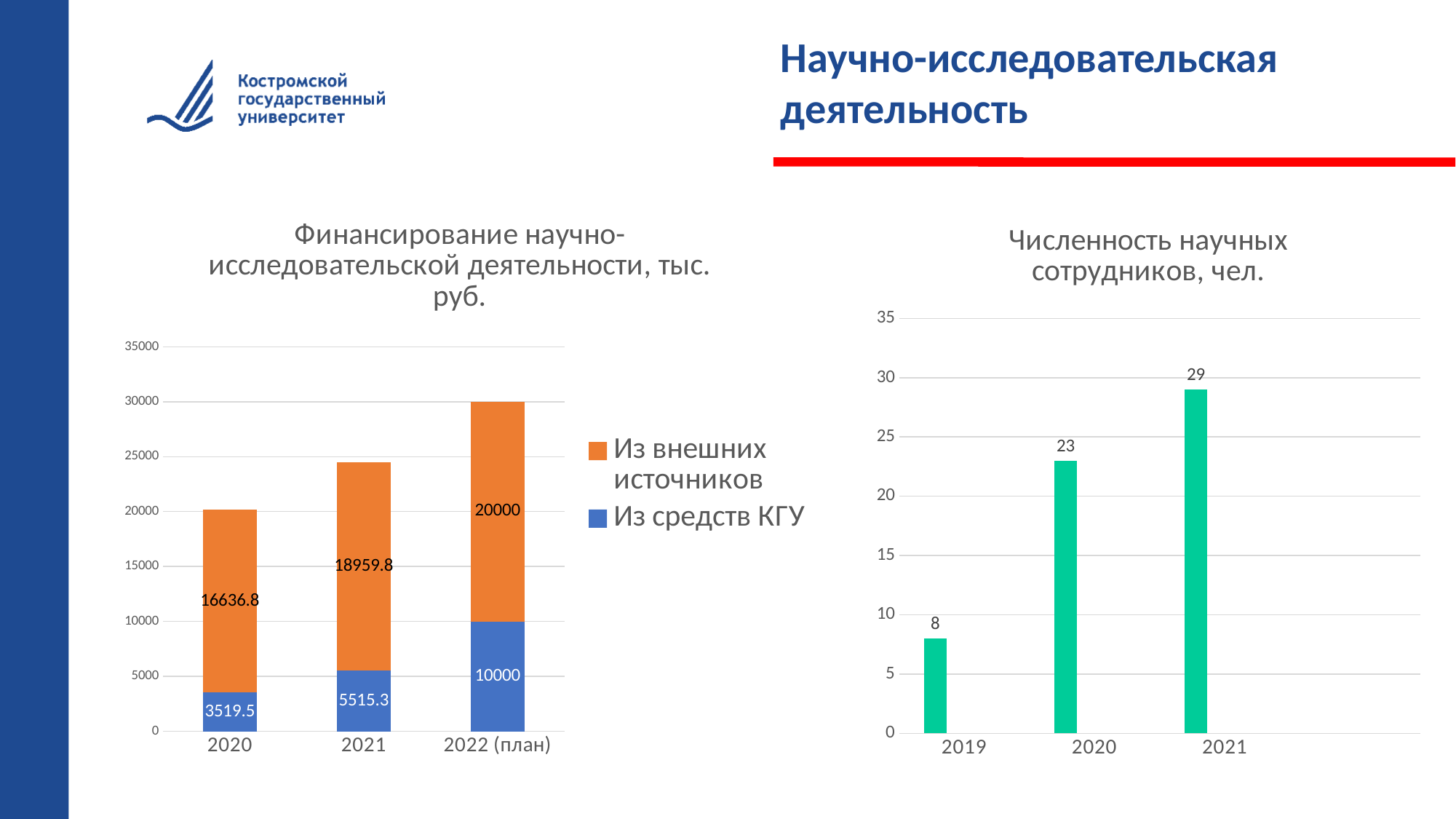
In the chart 'Финансирование научно-исследовательской деятельности, тыс. руб.', what is the value for 'Из средств КГУ' in 2020? 3519.5 In the chart 'Численность научных сотрудников, чел.', which year has the lowest value? 2019 In the chart 'Численность научных сотрудников, чел.', do the values rise or fall from 2019 to 2021? Rise In the chart 'Финансирование научно-исследовательской деятельности, тыс. руб.', what is the value for 'Из внешних источников' in 2021? 18959.8 What kind of chart is 'Численность научных сотрудников, чел.'? Bar chart In the chart 'Финансирование научно-исследовательской деятельности, тыс. руб.', which colour represents 'Из внешних источников'? Orange In the chart 'Численность научных сотрудников, чел.', what is the difference between 2021 and 2019? 21 In the chart 'Финансирование научно-исследовательской деятельности, тыс. руб.', which year has the highest value for 'Из средств КГУ'? 2022 (план) In the chart 'Финансирование научно-исследовательской деятельности, тыс. руб.', how many series does the legend list? 2 In the chart 'Численность научных сотрудников, чел.', what is the value for 2020? 23 In the chart 'Финансирование научно-исследовательской деятельности, тыс. руб.', what is the total of the stacked bar for 2022 (план)? 30000 In the chart 'Финансирование научно-исследовательской деятельности, тыс. руб.', what is the difference between 'Из внешних источников' and 'Из средств КГУ' in 2022 (план)? 10000